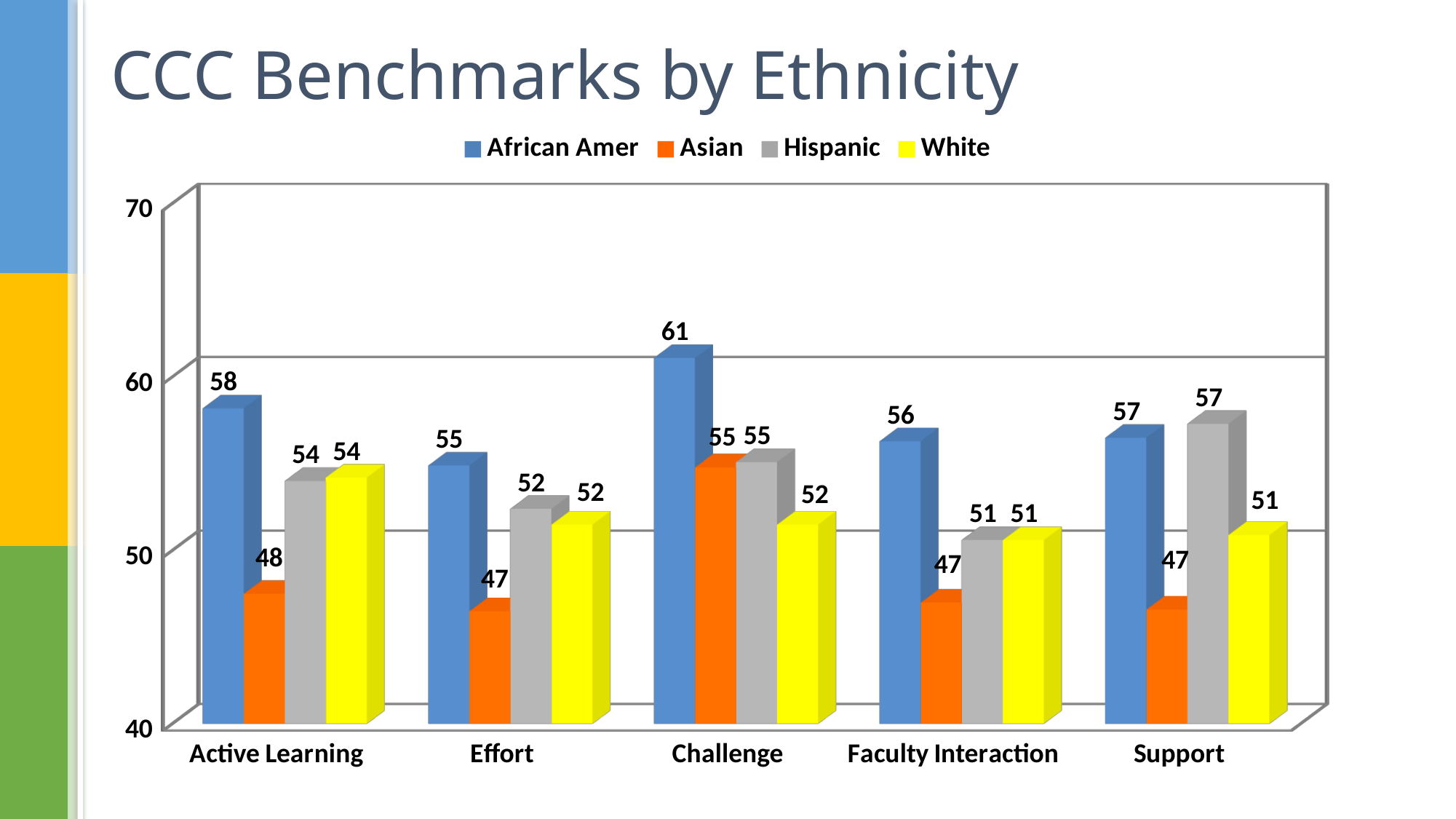
What is the value for Asian in the Active Learning category? 48 What is the value for White in the Effort category? 52 Which category has the lowest value for White? Faculty Interaction and Support (both 51) Which category has the highest value for African Amer? Challenge What is the value for African Amer in the Challenge category? 61 How many series does the legend list? 4 Which is larger in the Support category, the African Amer value or the White value? African Amer What kind of chart is shown on the slide? Bar chart What is the difference between the African Amer and Asian values in the Challenge category? 6 What is the title of the chart? CCC Benchmarks by Ethnicity How many categories are shown on the x axis? 5 What is the value for Hispanic in the Support category? 57